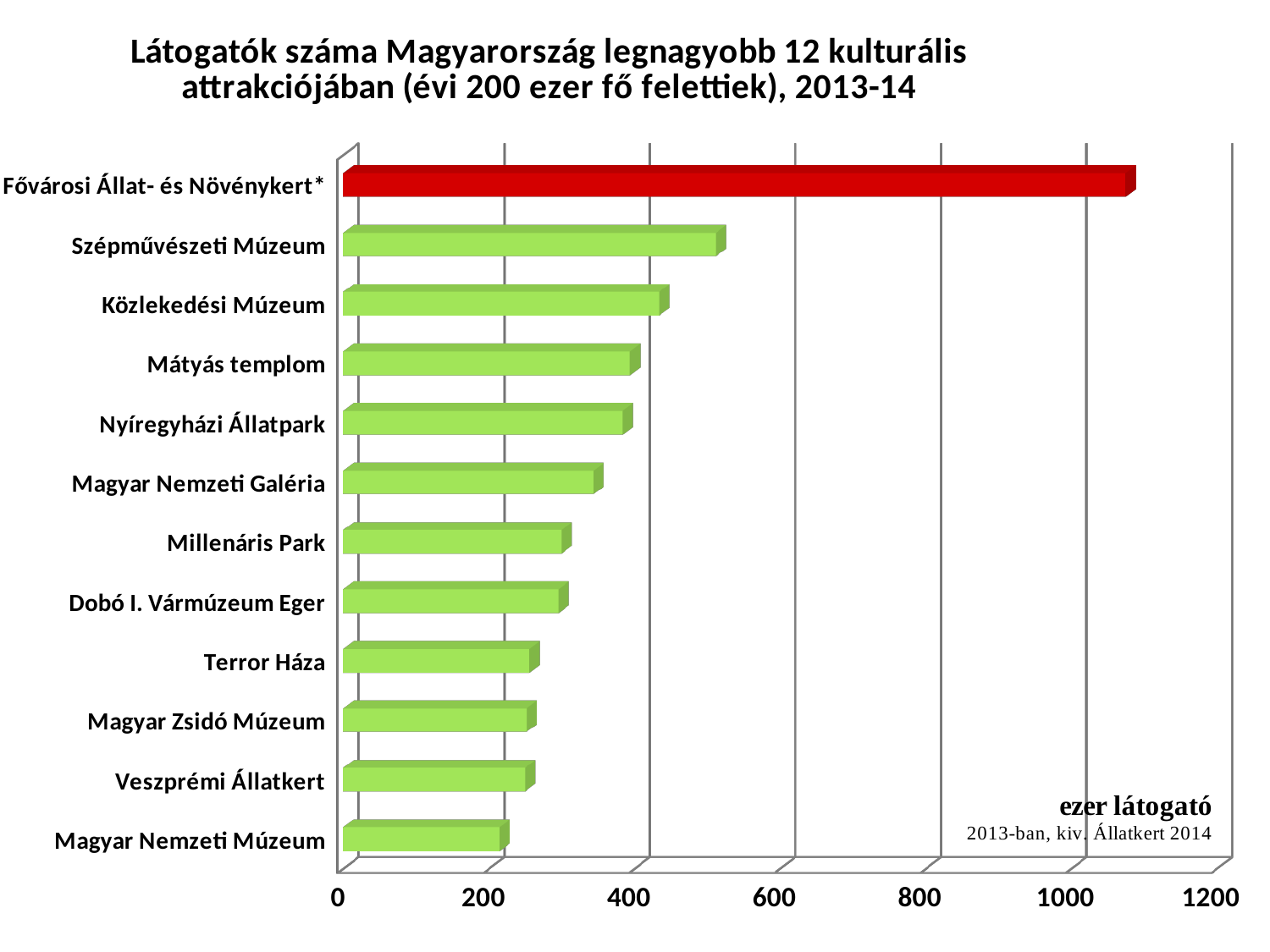
How many attractions (categories) are plotted in the chart? 12 Which has more visitors, Szépművészeti Múzeum or Közlekedési Múzeum? Szépművészeti Múzeum Is the value for Terror Háza greater or less than 200? greater Is the value for Szépművészeti Múzeum greater or less than 600? less What kind of chart is shown on the slide? bar chart What colour is the bar for Fővárosi Állat- és Növénykert*? red Which attraction has the highest number of visitors in the chart? Fővárosi Állat- és Növénykert* Which has more visitors, Magyar Nemzeti Galéria or Millenáris Park? Magyar Nemzeti Galéria Is the value for Fővárosi Állat- és Növénykert* greater or less than 1000? greater Which attraction has the lowest number of visitors in the chart? Magyar Nemzeti Múzeum